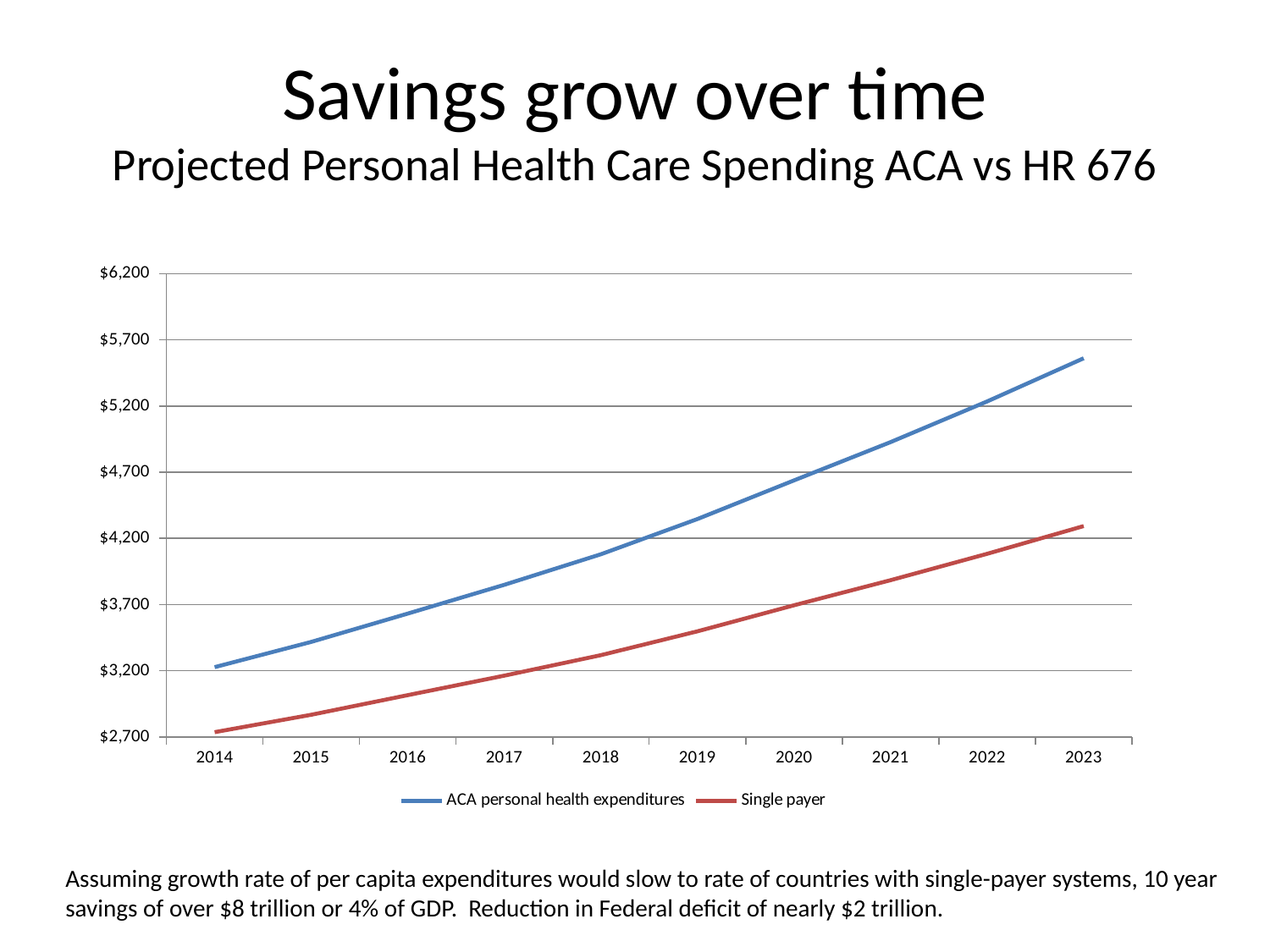
What kind of chart is shown on the slide? line chart Is the value for ACA personal health expenditures in 2023 greater or less than $5,200? greater Do the values for ACA personal health expenditures rise or fall from 2014 to 2023? rise What colour is the line for Single payer? red Is the value for Single payer in 2018 greater or less than $3,700? less In which year is the value for ACA personal health expenditures highest? 2023 In which year is the value for Single payer lowest? 2014 How many years are plotted along the x axis? 10 Do the values for Single payer rise or fall from 2014 to 2023? rise In 2023, which series has the larger value, ACA personal health expenditures or Single payer? ACA personal health expenditures How many series does the legend list? 2 Is the value for ACA personal health expenditures in 2018 greater or less than $4,200? less